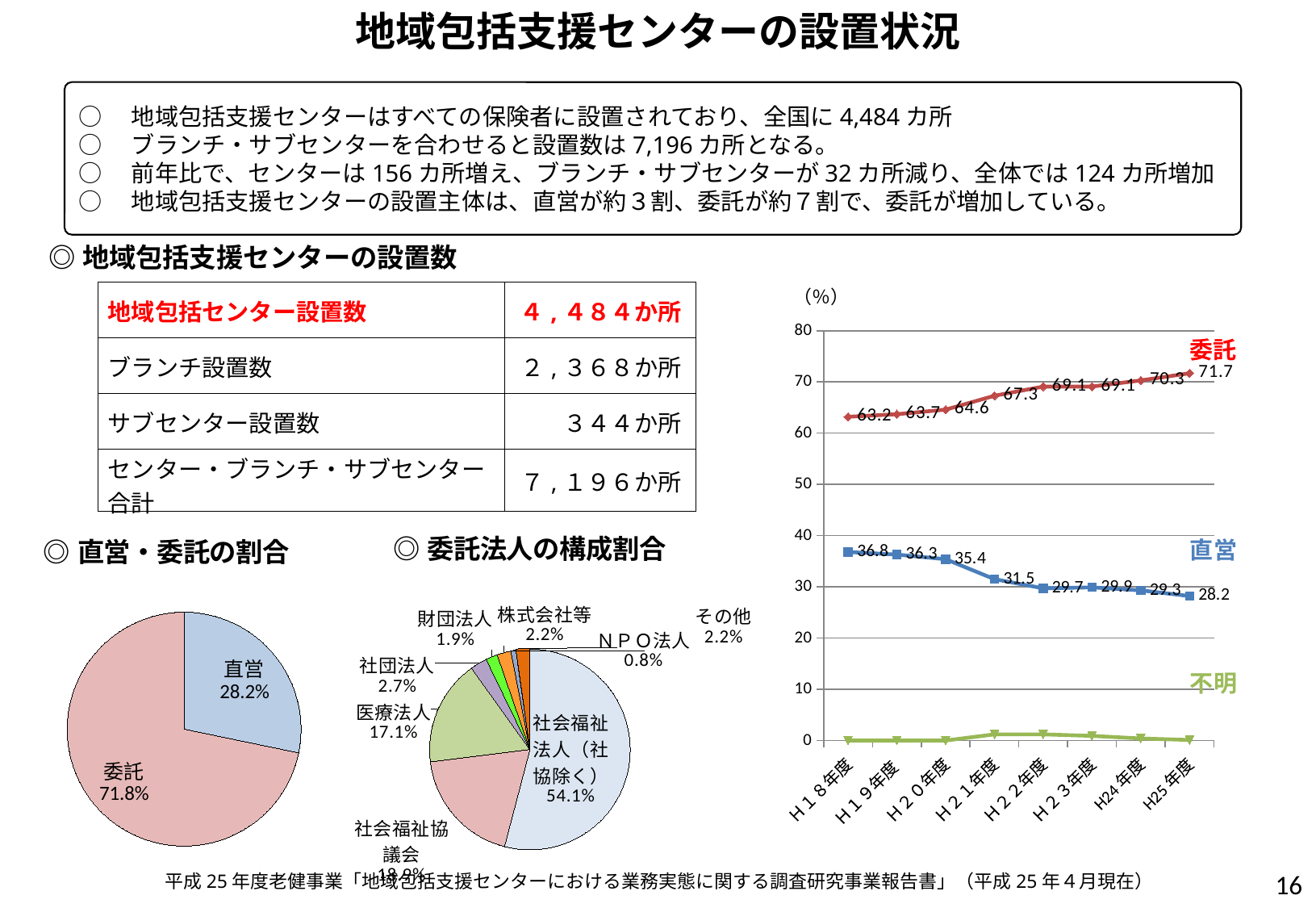
In the line chart on the right, does the 直営 series rise or fall from H18年度 to H25年度? fall In the line chart on the right, what is the value for 委託 in H25年度? 71.7 In the line chart on the right, how many series are plotted? 3 In the line chart on the right, what is the value for 直営 in H18年度? 36.8 In the line chart on the right, in which year is the 委託 value highest? H25年度 What kind of chart is the chart on the right side of the slide? line chart In the line chart on the right, which is larger: the 直営 value in H21年度 or in H22年度? H21年度 In the pie chart 委託法人の構成割合, what share is 医療法人? 17.1% In the line chart on the right, how many years are shown on the x axis? 8 In the pie chart 委託法人の構成割合, which category has the largest share? 社会福祉法人（社協除く） In the pie chart 直営・委託の割合, what share is 委託? 71.8% In the line chart on the right, by how much did the 委託 value increase from H18年度 (63.2) to H25年度 (71.7)? 8.5